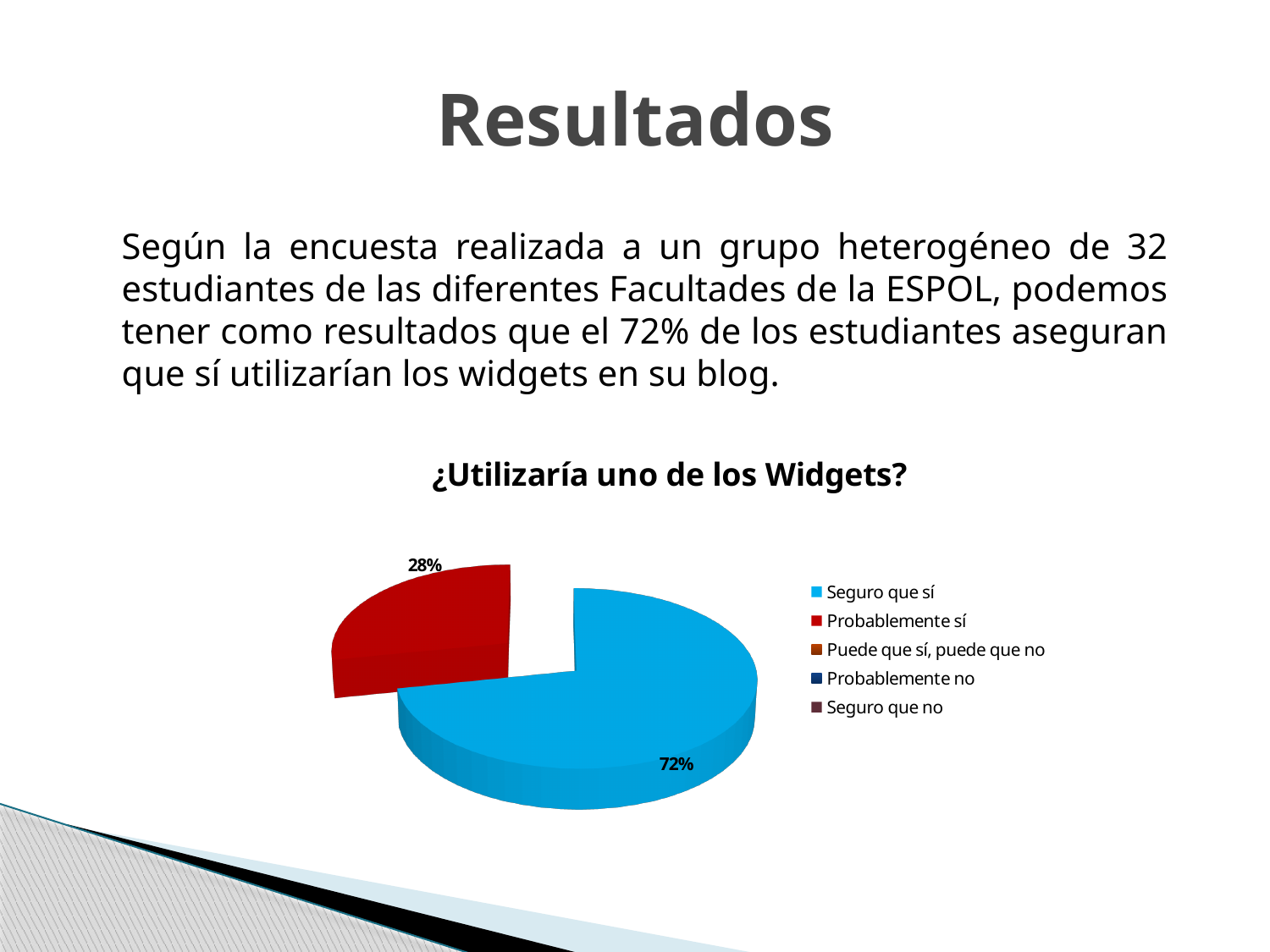
Which category has the largest slice of the pie? Seguro que sí What is the difference in percentage points between the "Seguro que sí" slice and the "Probablemente sí" slice? 44 What colour is the "Seguro que sí" slice? blue What percentage of the pie corresponds to "Probablemente sí"? 28% What is the combined share of the "Seguro que sí" and "Probablemente sí" slices? 100% How many entries does the legend list? 5 What kind of chart is shown on the slide? pie chart Which of the two labelled slices is smaller, "Seguro que sí" or "Probablemente sí"? Probablemente sí Which is larger, the "Seguro que sí" slice or the "Probablemente sí" slice? Seguro que sí How many slices with data labels are visible in the pie? 2 What percentage of the pie corresponds to "Seguro que sí"? 72% What is the title of the chart? ¿Utilizaría uno de los Widgets?